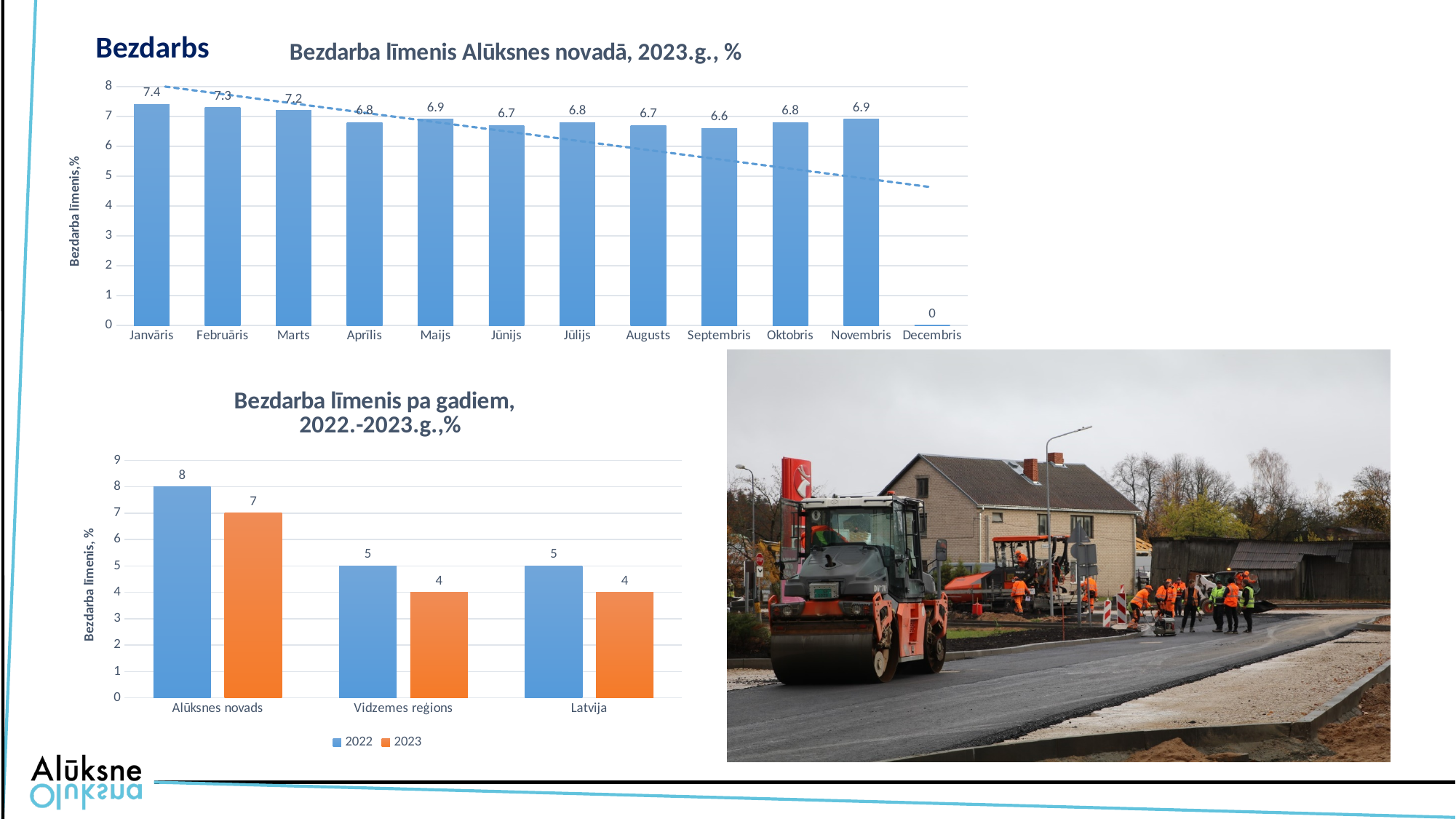
In the chart 'Bezdarba līmenis Alūksnes novadā, 2023.g., %', how many months are shown on the x axis? 12 In the chart 'Bezdarba līmenis Alūksnes novadā, 2023.g., %', which month has the highest value? Janvāris In the chart 'Bezdarba līmenis pa gadiem, 2022.-2023.g.,%', what is the 2023 value for Alūksnes novads? 7 In the chart 'Bezdarba līmenis pa gadiem, 2022.-2023.g.,%', which category has the highest 2022 value? Alūksnes novads In the chart 'Bezdarba līmenis Alūksnes novadā, 2023.g., %', which is larger, the value for Marts or the value for Aprīlis? Marts In the chart 'Bezdarba līmenis pa gadiem, 2022.-2023.g.,%', what is the 2022 value for Latvija? 5 In the chart 'Bezdarba līmenis Alūksnes novadā, 2023.g., %', what is the value for Janvāris? 7.4 In the chart 'Bezdarba līmenis pa gadiem, 2022.-2023.g.,%', what is the difference between the 2022 and 2023 values for Vidzemes reģions? 1 In the chart 'Bezdarba līmenis Alūksnes novadā, 2023.g., %', what is the value for Septembris? 6.6 In the chart 'Bezdarba līmenis pa gadiem, 2022.-2023.g.,%', how many series does the legend list? 2 In the chart 'Bezdarba līmenis Alūksnes novadā, 2023.g., %', what is the difference between the values for Janvāris and Novembris? 0.5 In the chart 'Bezdarba līmenis Alūksnes novadā, 2023.g., %', what kind of chart is used? Bar chart